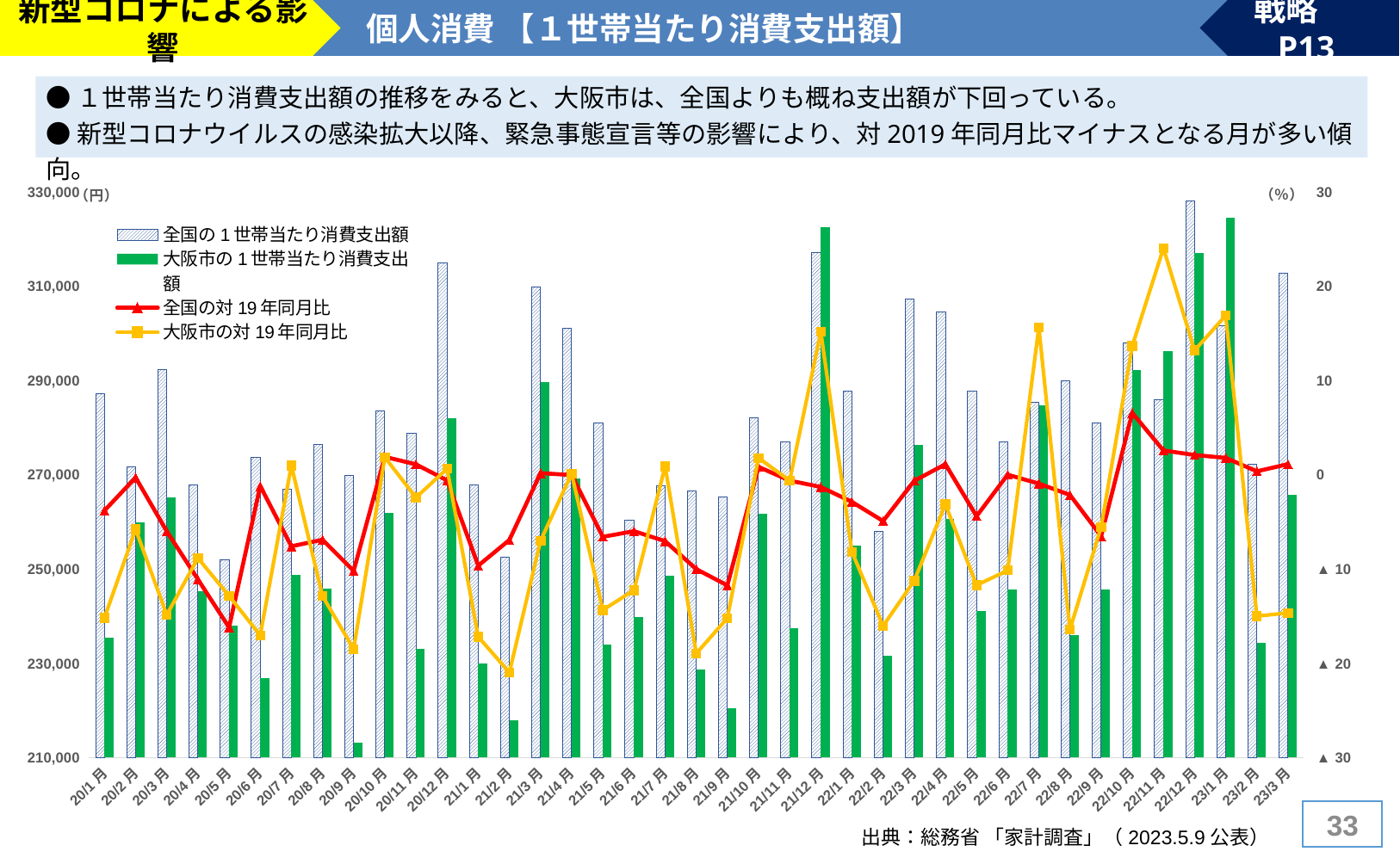
For 21/12月, which is larger: 全国の１世帯当たり消費支出額 or 大阪市の１世帯当たり消費支出額? 大阪市の１世帯当たり消費支出額 Which month has the highest bar for 全国の１世帯当たり消費支出額? 22/12月 What is the title of the chart on the slide? 個人消費 【１世帯当たり消費支出額】 In which month does the 全国の対19年同月比 line reach its lowest point? 20/5月 How many series does the legend list? 4 Is the value of 全国の１世帯当たり消費支出額 for 22/12月 greater or less than 310,000? greater In which month does the 大阪市の対19年同月比 line reach its highest point? 22/11月 Is the value of 大阪市の１世帯当たり消費支出額 for 20/9月 greater or less than 230,000? less For 20/1月, which is larger: 全国の１世帯当たり消費支出額 or 大阪市の１世帯当たり消費支出額? 全国の１世帯当たり消費支出額 Which month has the lowest bar for 大阪市の１世帯当たり消費支出額? 20/9月 How many months are shown along the x axis? 39 What kind of chart is shown on the slide? A combined bar and line chart